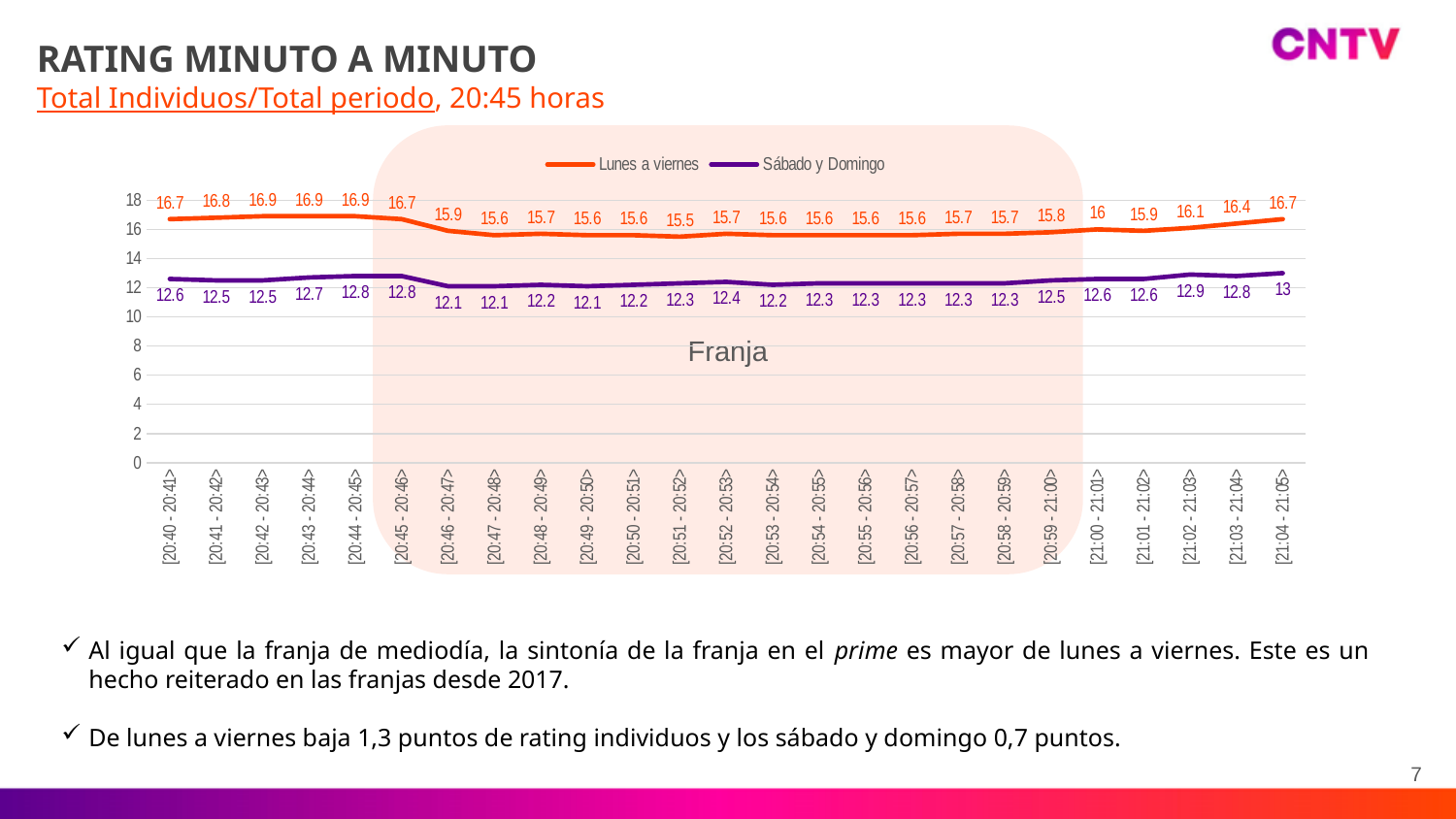
At which time interval does the Sábado y Domingo series reach its highest value? [21:04 - 21:05> How many time intervals are shown on the x axis? 25 What kind of chart is shown on the slide? Line chart Which series is drawn in orange? Lunes a viernes What is the value for Lunes a viernes at [20:40 - 20:41>? 16.7 What is the value for Lunes a viernes at [20:51 - 20:52>? 15.5 How many series does the legend list? 2 What is the value for Sábado y Domingo at [20:52 - 20:53>? 12.4 Which series has the higher value at [20:47 - 20:48>, Lunes a viernes or Sábado y Domingo? Lunes a viernes What is the value for Sábado y Domingo at [21:04 - 21:05>? 13 At which time interval does the Lunes a viernes series reach its lowest value? [20:51 - 20:52> What is the difference between Lunes a viernes and Sábado y Domingo at [20:40 - 20:41>? 4.1